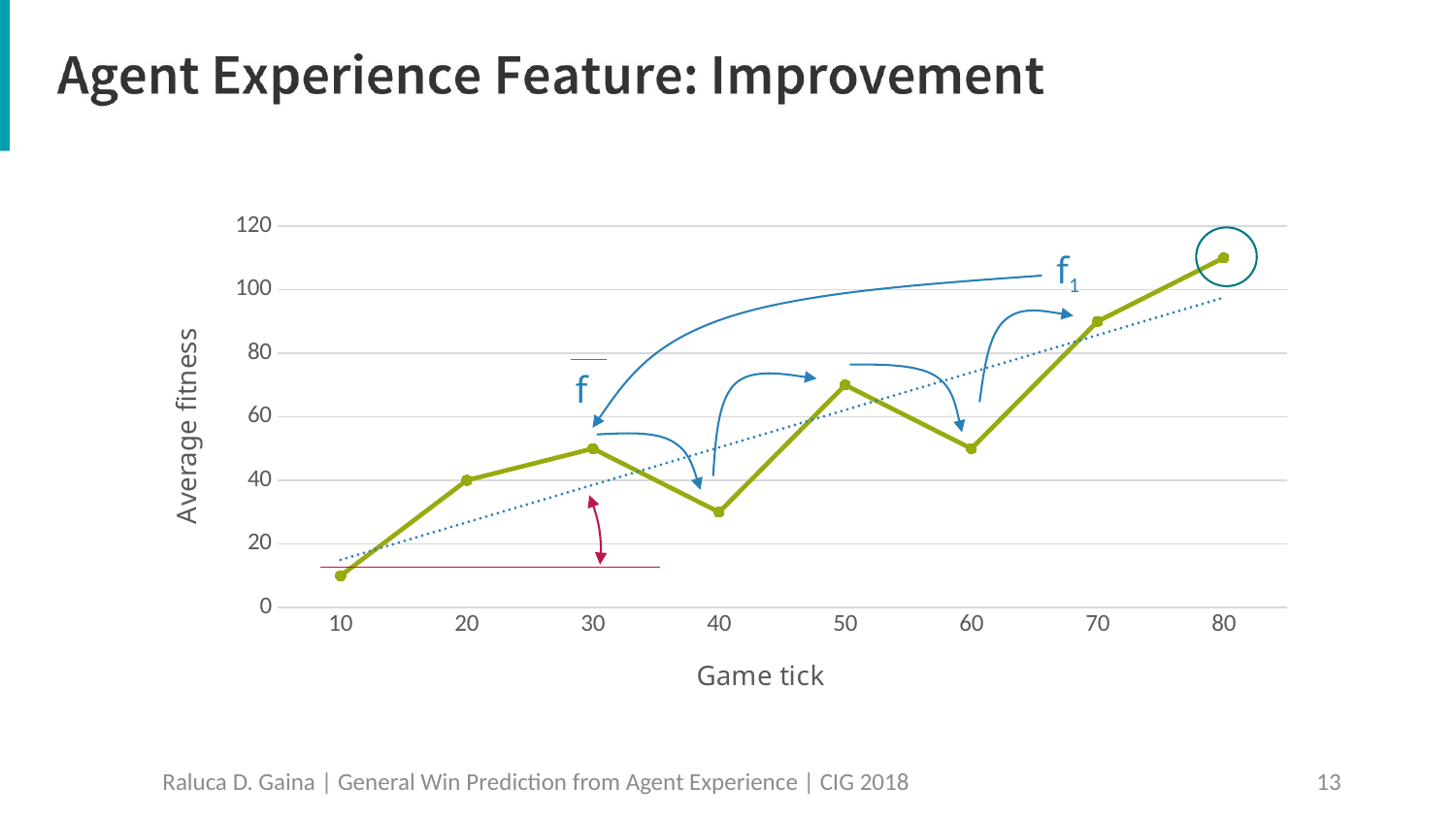
What is the label of the y axis? Average fitness Is the average fitness at game tick 40 greater or less than 40? less At which game tick is the average fitness highest? 80 Is the average fitness at game tick 80 greater or less than 100? greater Overall, does the average fitness rise or fall as the game tick increases from 10 to 80? rise Which has the higher average fitness, game tick 30 or game tick 40? game tick 30 What is the average fitness at game tick 20? 40 At which game tick is the average fitness lowest? 10 What kind of chart is shown on the slide? line chart Is the average fitness at game tick 50 greater or less than 60? greater What is the label of the x axis? Game tick How many data points are plotted on the solid line? 8